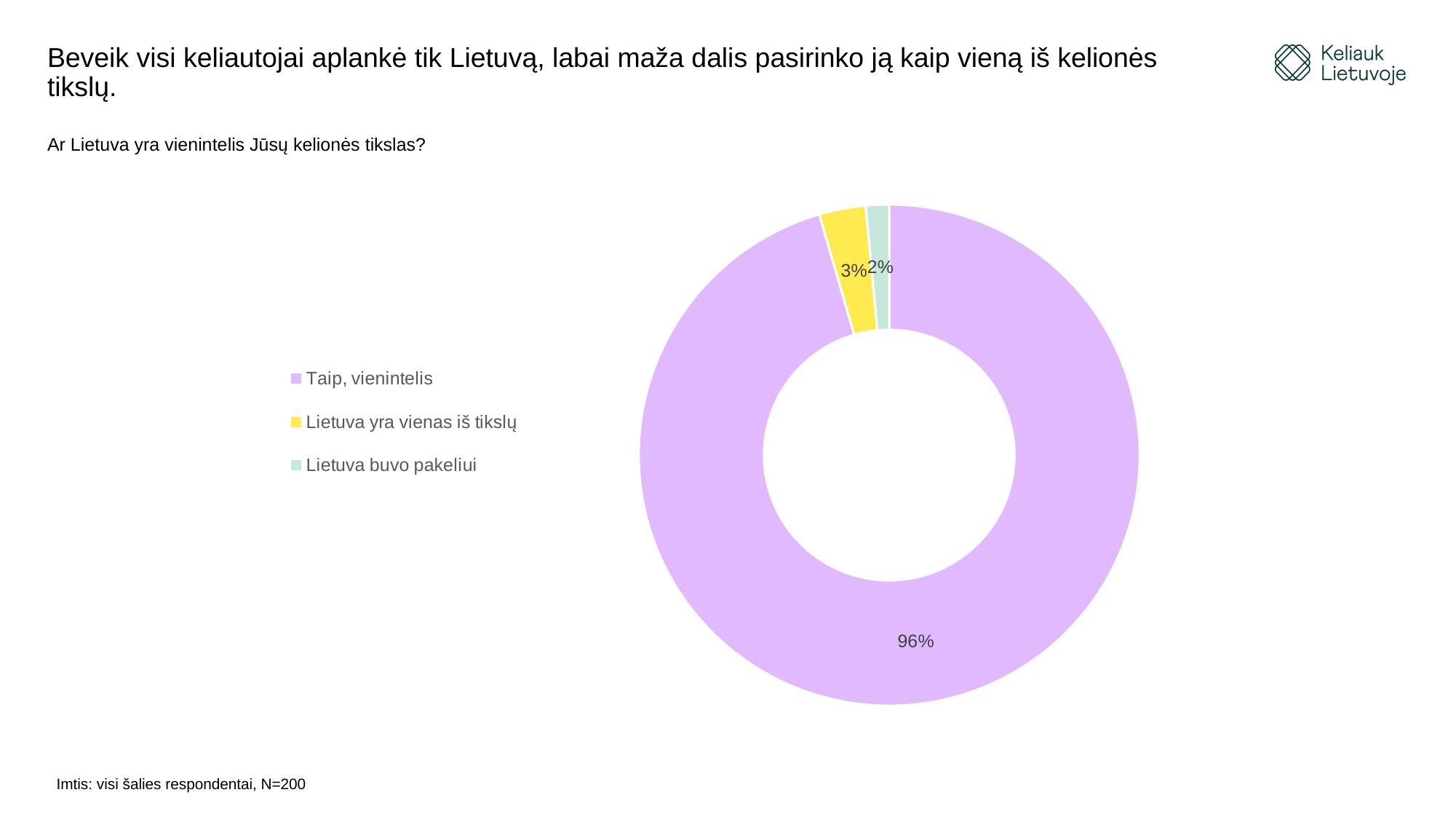
What share of respondents answered "Taip, vienintelis"? 96% What is the combined share of "Lietuva yra vienas iš tikslų" and "Lietuva buvo pakeliui"? 5% Which category has the largest share of the pie? Taip, vienintelis What is the difference in percentage points between "Taip, vienintelis" and "Lietuva yra vienas iš tikslų"? 93 What is the sample size stated on the slide? N=200 What share of respondents answered "Lietuva buvo pakeliui"? 2% What kind of chart is shown on the slide? Pie chart (doughnut) Which category has the smallest share of the pie? Lietuva buvo pakeliui What share of respondents answered "Lietuva yra vienas iš tikslų"? 3% Which is larger: the share for "Lietuva yra vienas iš tikslų" or for "Lietuva buvo pakeliui"? Lietuva yra vienas iš tikslų How many categories does the chart show? 3 What colour is the slice for "Lietuva yra vienas iš tikslų"? Yellow